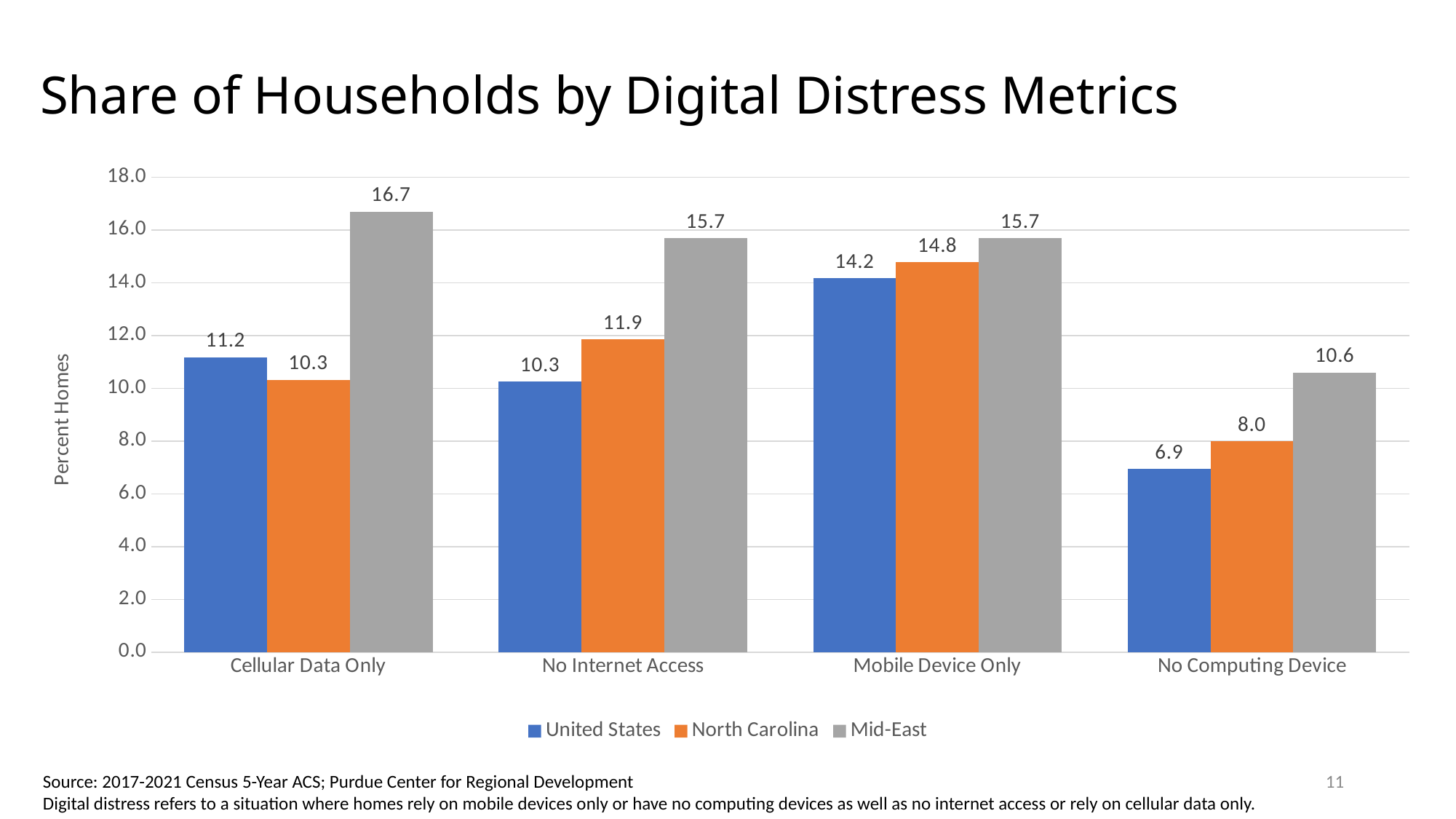
What is the North Carolina value for No Internet Access? 11.9 How many series does the legend list? 3 Which is larger for Cellular Data Only: the United States value or the North Carolina value? United States Which category has the highest Mid-East value? Cellular Data Only How many categories are shown on the x axis? 4 Is the North Carolina value for Mobile Device Only greater or less than 14.0? greater What is the label of the vertical axis? Percent Homes What kind of chart is shown on the slide? Bar chart What is the Mid-East value for Cellular Data Only? 16.7 Which category has the lowest United States value? No Computing Device What is the difference between the Mid-East and United States values for No Computing Device? 3.7 What is the United States value for No Computing Device? 6.9